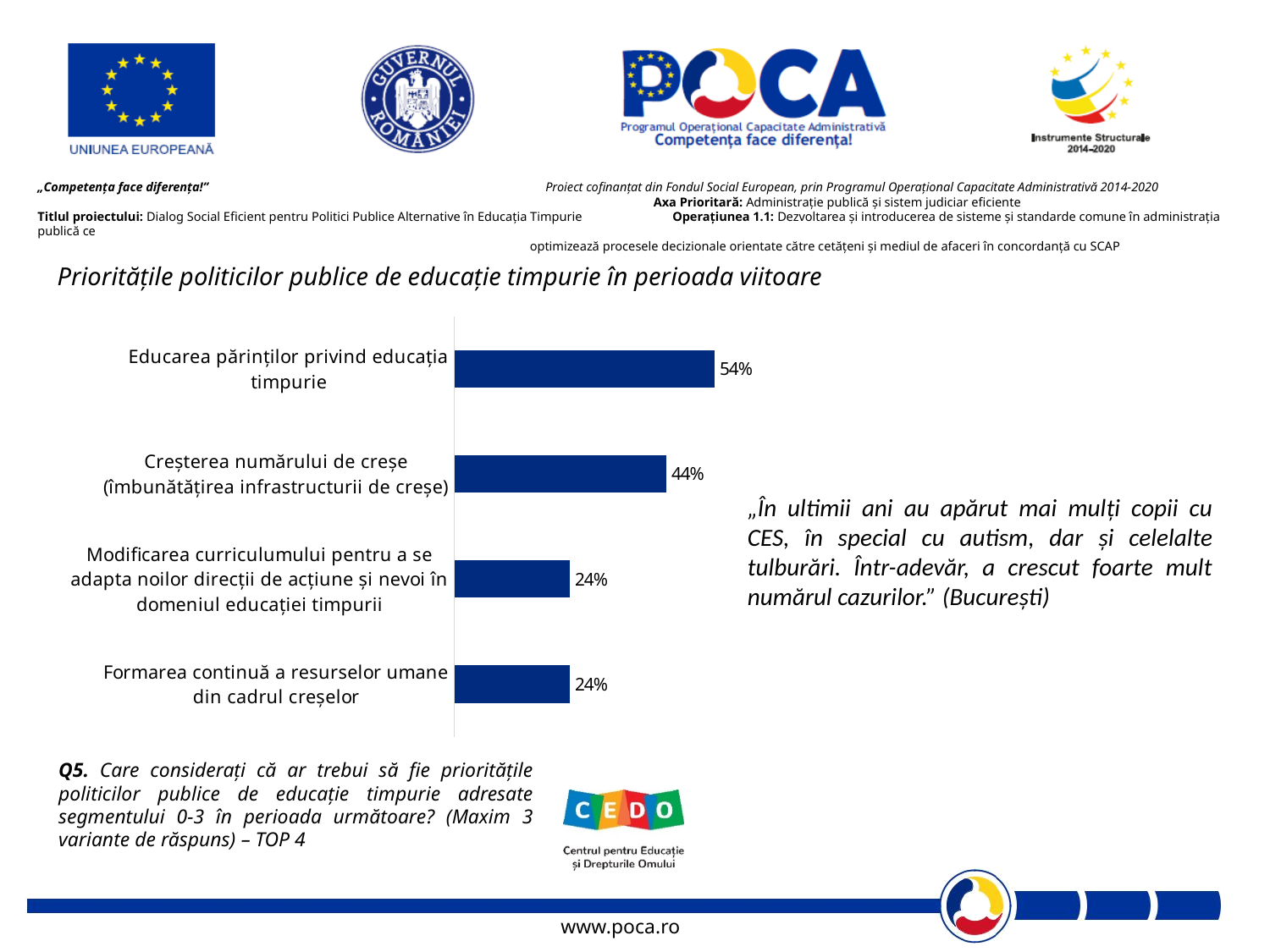
What is the value for "Formarea continuă a resurselor umane din cadrul creșelor"? 24% Which two categories share the same value? Modificarea curriculumului pentru a se adapta noilor direcții de acțiune și nevoi în domeniul educației timpurii; Formarea continuă a resurselor umane din cadrul creșelor Which is larger: the value for "Creșterea numărului de creșe" or the value for "Formarea continuă a resurselor umane din cadrul creșelor"? Creșterea numărului de creșe What kind of chart is shown on the slide? Bar chart What is the value for "Educarea părinților privind educația timpurie"? 54% Which category has the highest value? Educarea părinților privind educația timpurie How many categories are shown in the chart? 4 What is the title of the chart? Prioritățile politicilor publice de educație timpurie în perioada viitoare What is the difference between the values for "Creșterea numărului de creșe" and "Modificarea curriculumului"? 20% What is the difference between the values for "Educarea părinților privind educația timpurie" and "Creșterea numărului de creșe"? 10% What is the value for "Creșterea numărului de creșe (îmbunătățirea infrastructurii de creșe)"? 44%